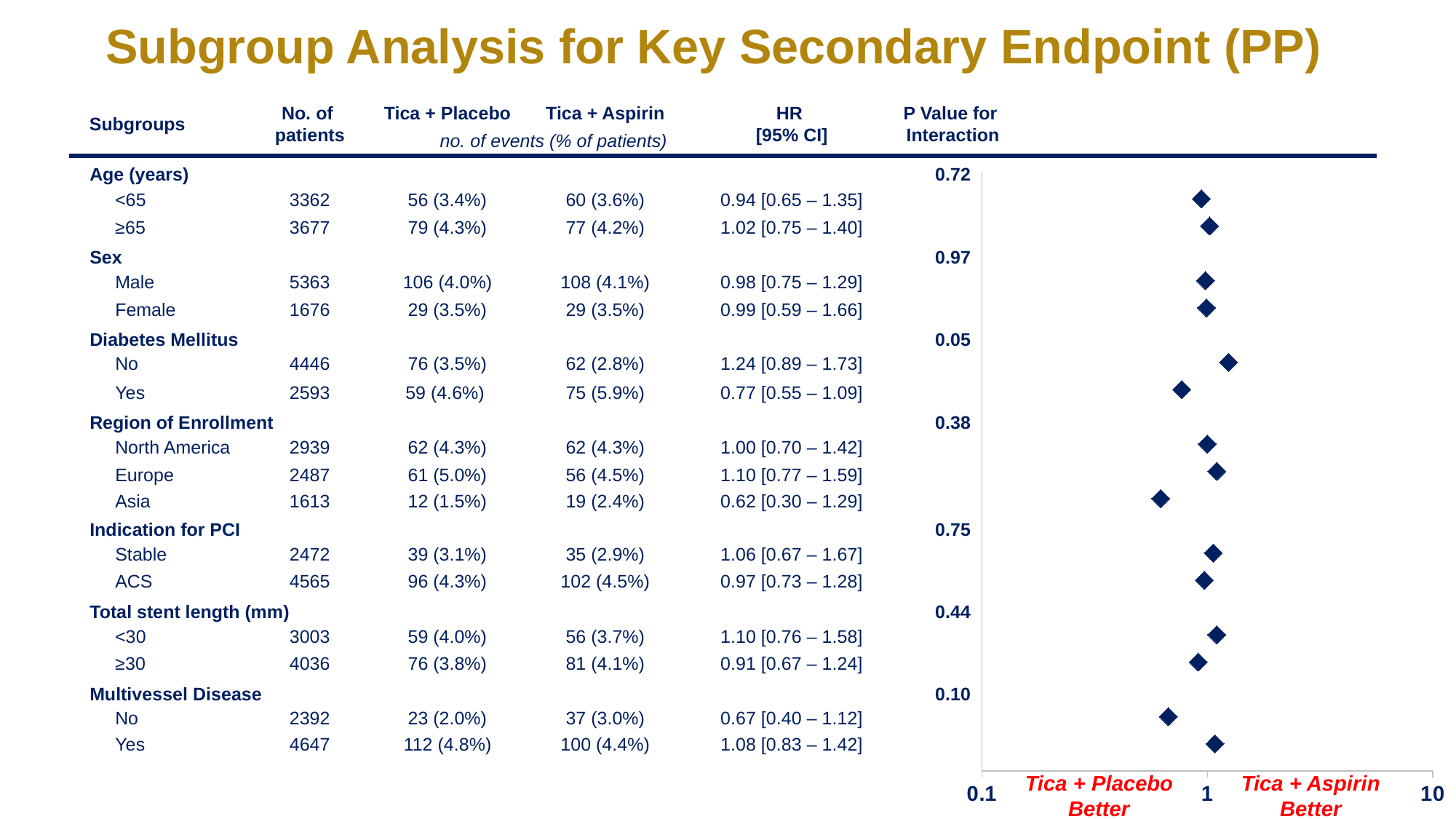
Is the hazard ratio for the Europe subgroup greater or less than 1? greater Is the hazard ratio for the Diabetes Mellitus 'Yes' subgroup greater or less than 1? less What kind of chart is shown on the right of the slide? Forest plot What is the hazard ratio plotted for the Asia subgroup? 0.62 Which subgroup has the lowest hazard ratio in the forest plot? Asia (0.62) What is the difference between the hazard ratios for Diabetes Mellitus 'No' and Diabetes Mellitus 'Yes'? 0.47 How many subgroup points are plotted in the forest plot? 15 What are the minimum and maximum values labelled on the x axis of the forest plot? 0.1 and 10 What is the P value for interaction for the Diabetes Mellitus subgroup? 0.05 Which has the larger hazard ratio: Multivessel Disease 'No' or Multivessel Disease 'Yes'? Multivessel Disease: Yes (1.08) Which subgroup has the highest hazard ratio in the forest plot? Diabetes Mellitus: No (1.24) What is the hazard ratio for the Female subgroup? 0.99